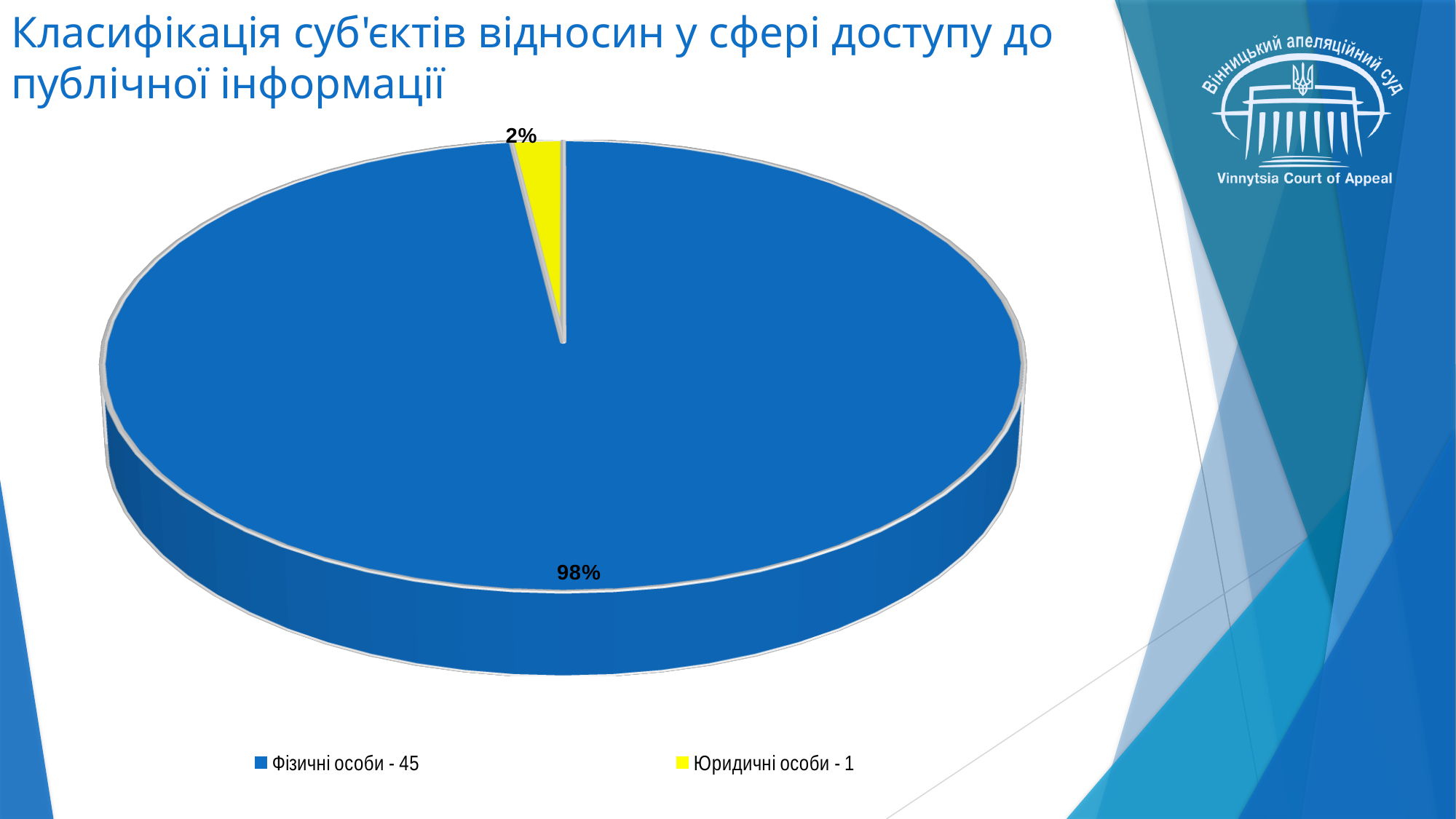
What is the difference in percentage points between the Фізичні особи slice and the Юридичні особи slice? 96 percentage points What percentage share does the slice for Фізичні особи have? 98% Which is larger, the share for Фізичні особи or the share for Юридичні особи? Фізичні особи What count is shown in the legend for Юридичні особи? 1 What kind of chart is shown on the slide? Pie chart How many entries does the legend list? 2 What colour is the slice for Юридичні особи? Yellow What count is shown in the legend for Фізичні особи? 45 How many slices does the pie chart have? 2 Which category has the smallest slice of the pie? Юридичні особи Which category has the largest slice of the pie? Фізичні особи What percentage share does the slice for Юридичні особи have? 2%